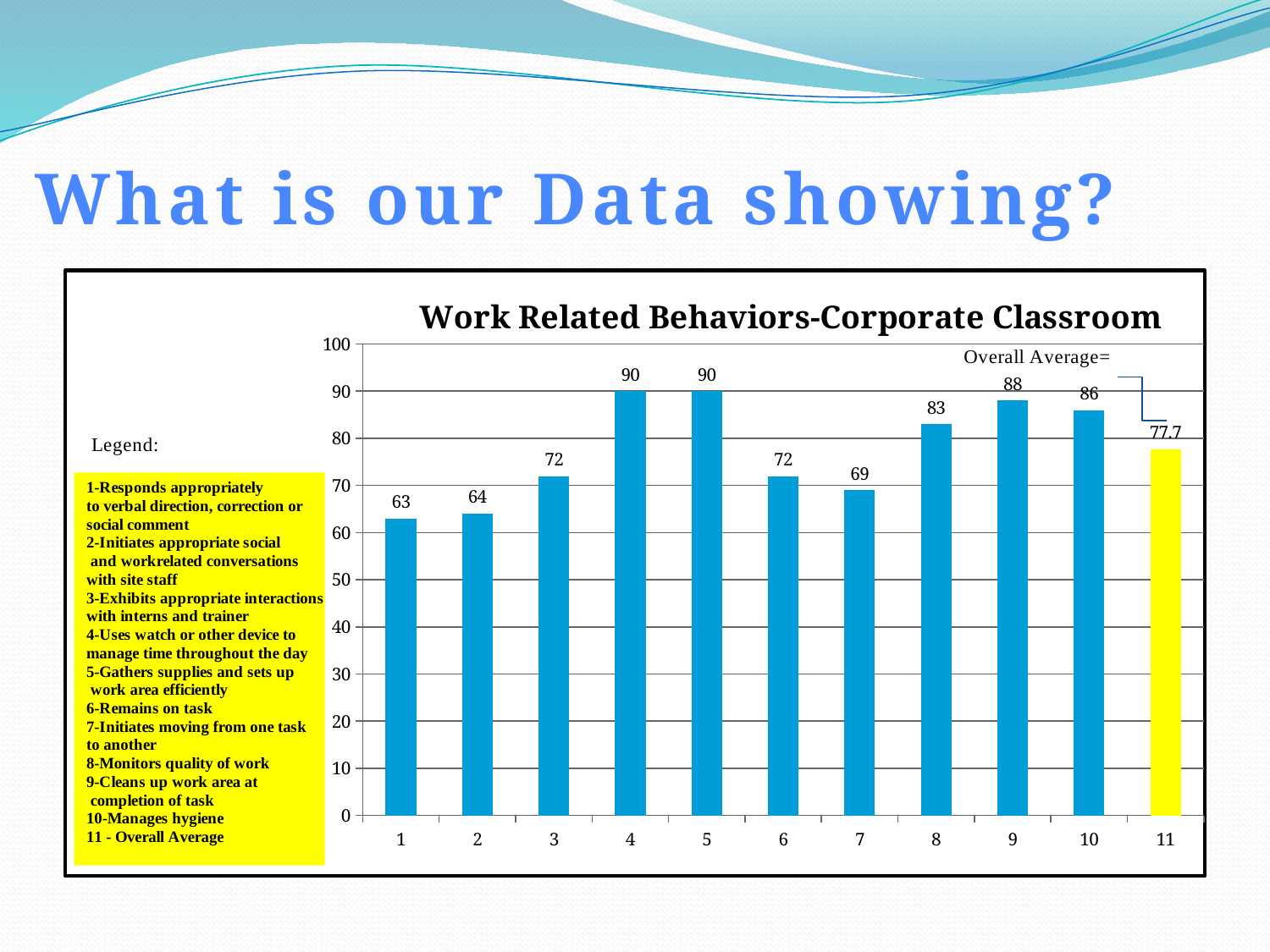
Which categories have the highest value in the chart? 4 and 5 What is the title of the chart? Work Related Behaviors-Corporate Classroom What is the value for category 8 in the chart? 83 How many categories are shown on the x axis of the chart? 11 What colour is the bar for category 11 in the chart? yellow Which category has the lowest value in the chart? 1 What is the difference between the values for category 9 and category 2? 24 What kind of chart is shown on the slide? bar chart What is the value shown for category 11 (Overall Average) in the chart? 77.7 Is the value for category 3 greater or less than 80? less Which is larger, the value for category 7 or the value for category 10? 10 What is the value for category 1 in the Work Related Behaviors-Corporate Classroom chart? 63